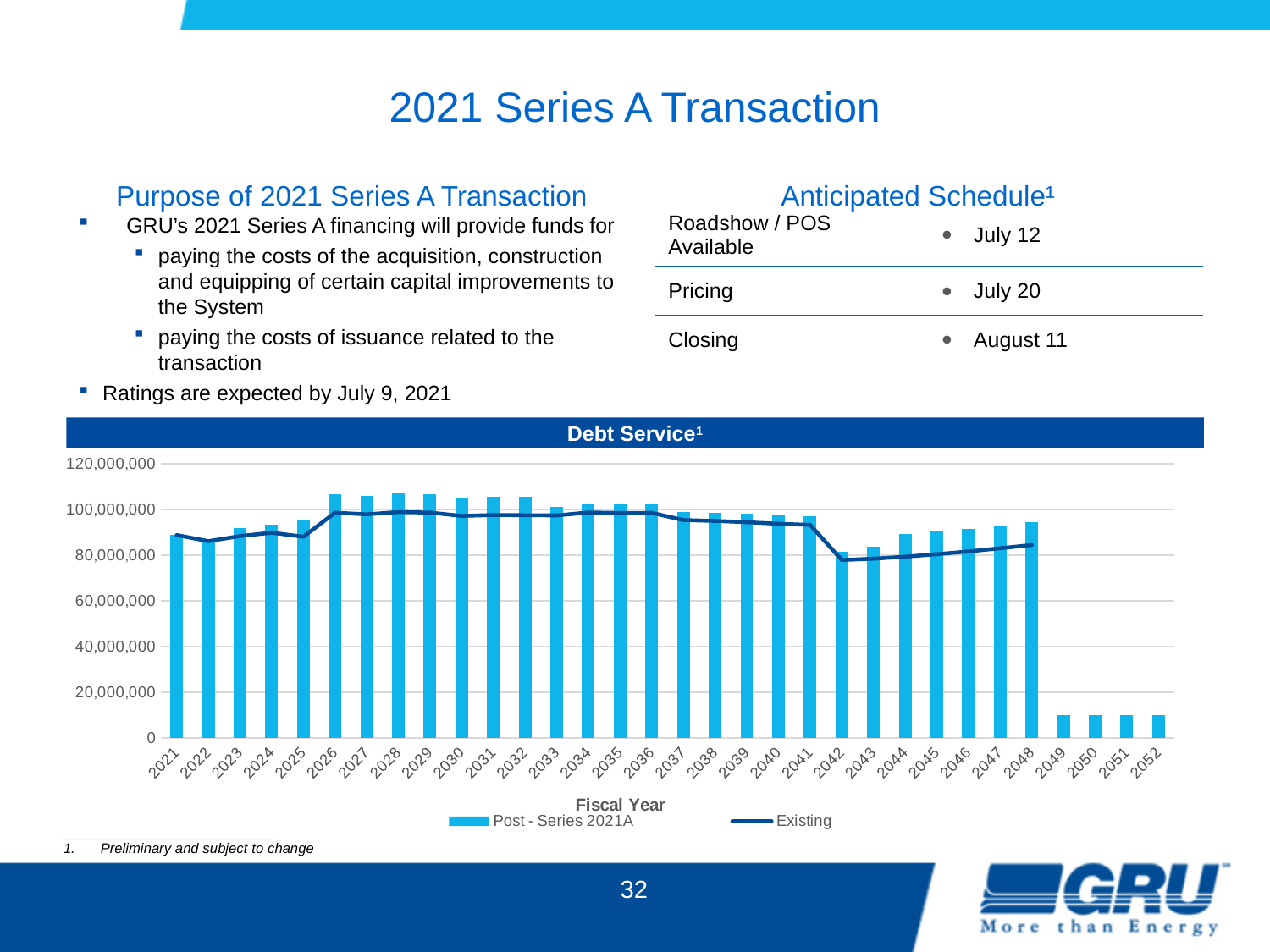
How many series does the legend of the Debt Service chart list? 2 Is the Post - Series 2021A value for 2049 greater or less than 20,000,000? less Is the Post - Series 2021A value for 2042 greater or less than 100,000,000? less What are the two series named in the legend of the Debt Service chart? Post - Series 2021A and Existing Do the Post - Series 2021A values rise or fall from 2048 to 2049? fall What is the label of the x axis on the Debt Service chart? Fiscal Year How many fiscal years are shown on the x axis of the Debt Service chart? 32 Is the Existing value for 2021 greater or less than 100,000,000? less What kind of chart is the Debt Service chart? bar chart with a line Which has the larger Post - Series 2021A value, 2028 or 2042? 2028 Which has the larger Post - Series 2021A value, 2048 or 2049? 2048